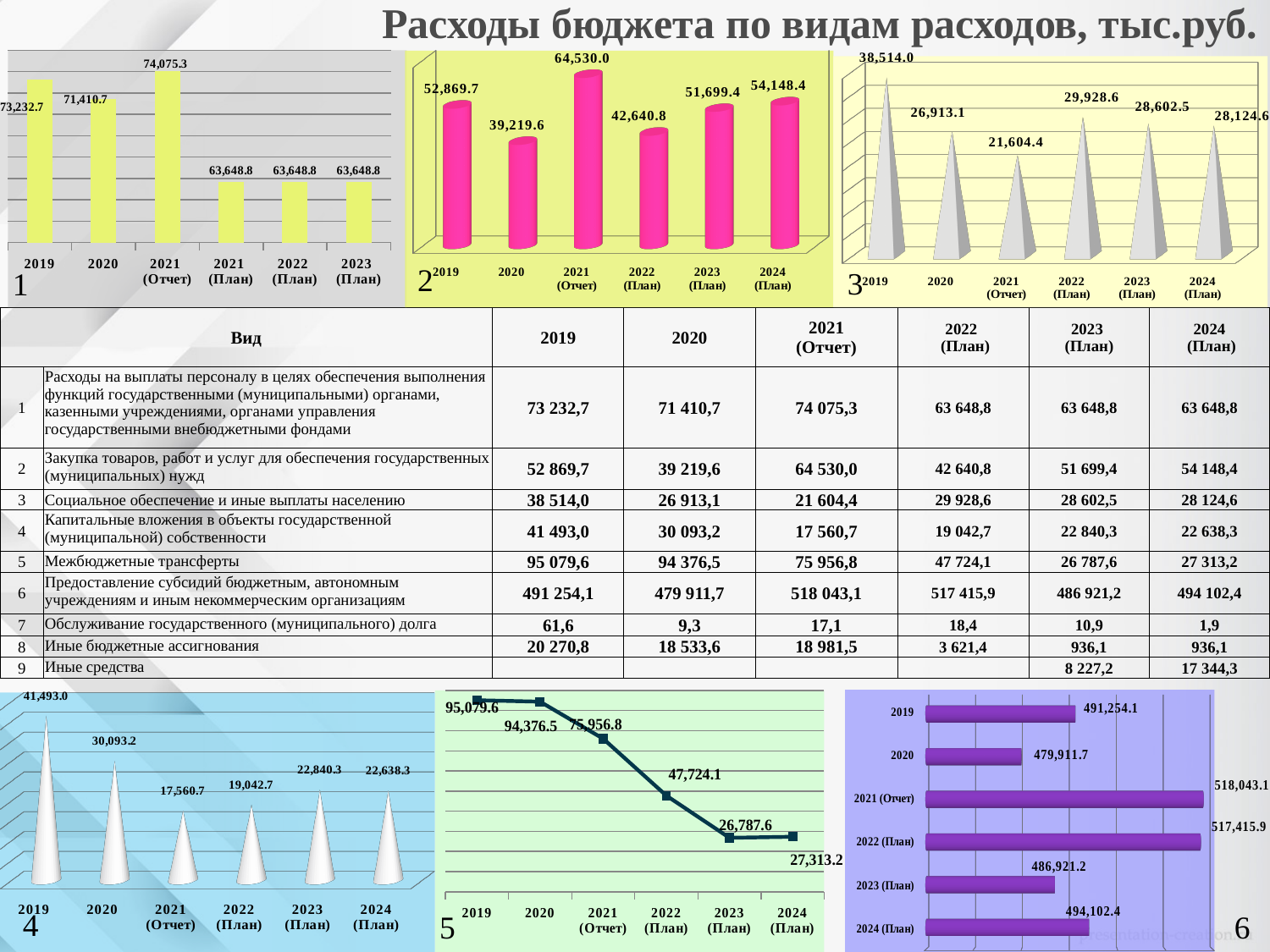
In chart 6 (bottom right), which is larger: the value for 2021 (Отчет) or 2022 (План)? 2021 (Отчет) How many categories are shown in chart 6 (bottom right)? 6 In chart 4 (bottom left), which category has the lowest value? 2021 (Отчет) In chart 3 (top right), which category has the highest value? 2019 In chart 2 (top middle), what is the difference between the values for 2021 (Отчет) and 2022 (План)? 21,889.2 In chart 1 (top left), which category has the highest value? 2021 (Отчет) In chart 3 (top right), what is the value for 2022 (План)? 29,928.6 In chart 5 (bottom middle), do the values generally rise or fall from 2019 to 2023 (План)? Fall In chart 2 (top middle), what is the value for 2020? 39,219.6 In chart 2 (top middle), which category has the lowest value? 2020 In chart 1 (top left), what is the value for 2021 (Отчет)? 74,075.3 In chart 5 (bottom middle), what kind of chart is shown? Line chart